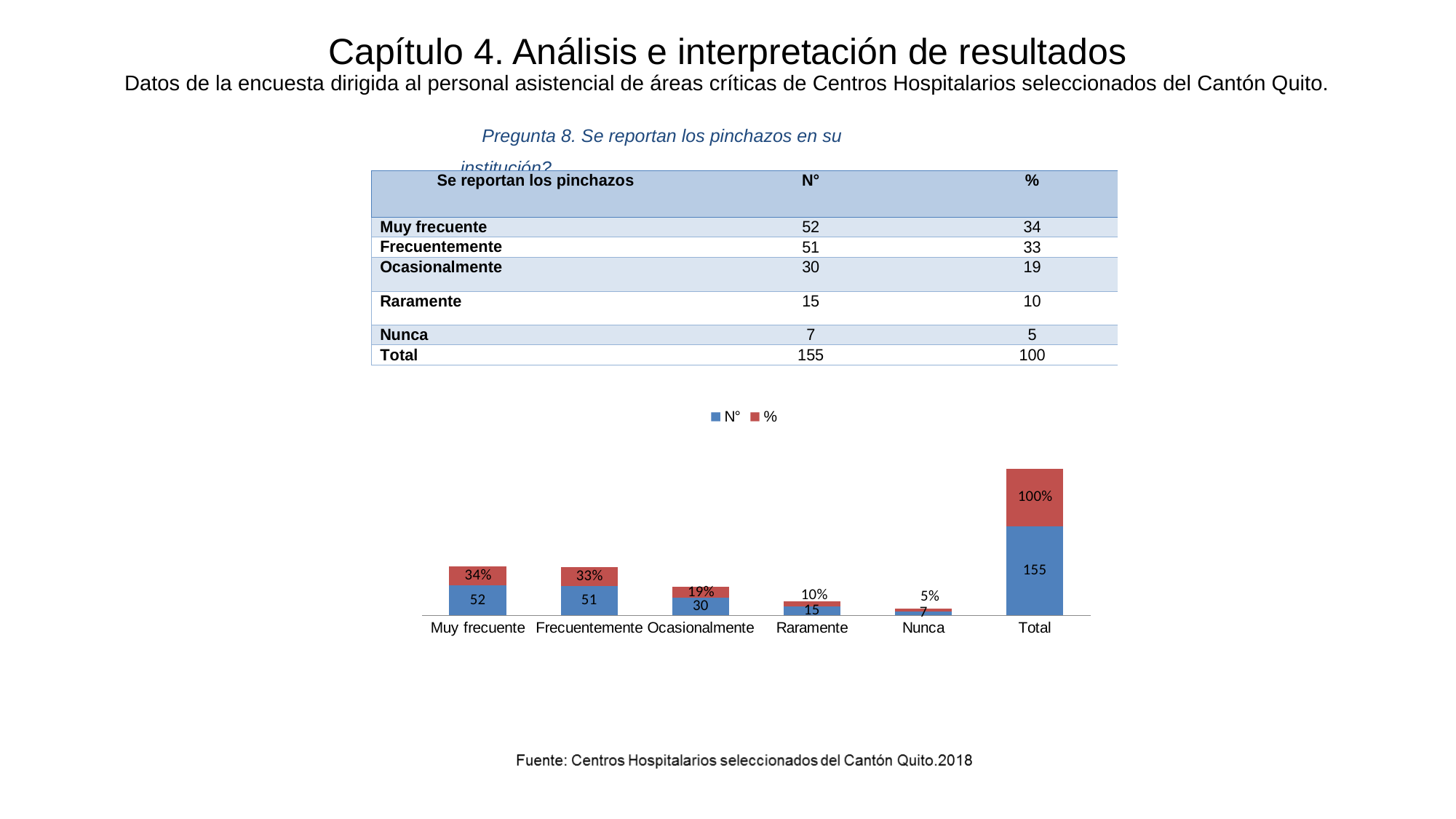
From Muy frecuente to Nunca, do the N° values rise or fall along the x axis? Fall Which category has the highest N° value in the chart? Total Which category has the lowest N° value in the chart? Nunca What kind of chart is shown on the slide? Stacked bar chart What is the % value shown for Raramente in the chart? 10% Which has a larger N° value, Ocasionalmente or Raramente? Ocasionalmente What is the % value shown for Ocasionalmente in the chart? 19% What is the N° value for Nunca in the chart? 7 How many categories are shown on the x axis of the chart? 6 What is the N° value for Muy frecuente in the chart? 52 What is the difference between the N° values for Muy frecuente and Ocasionalmente? 22 How many series does the chart legend list? 2